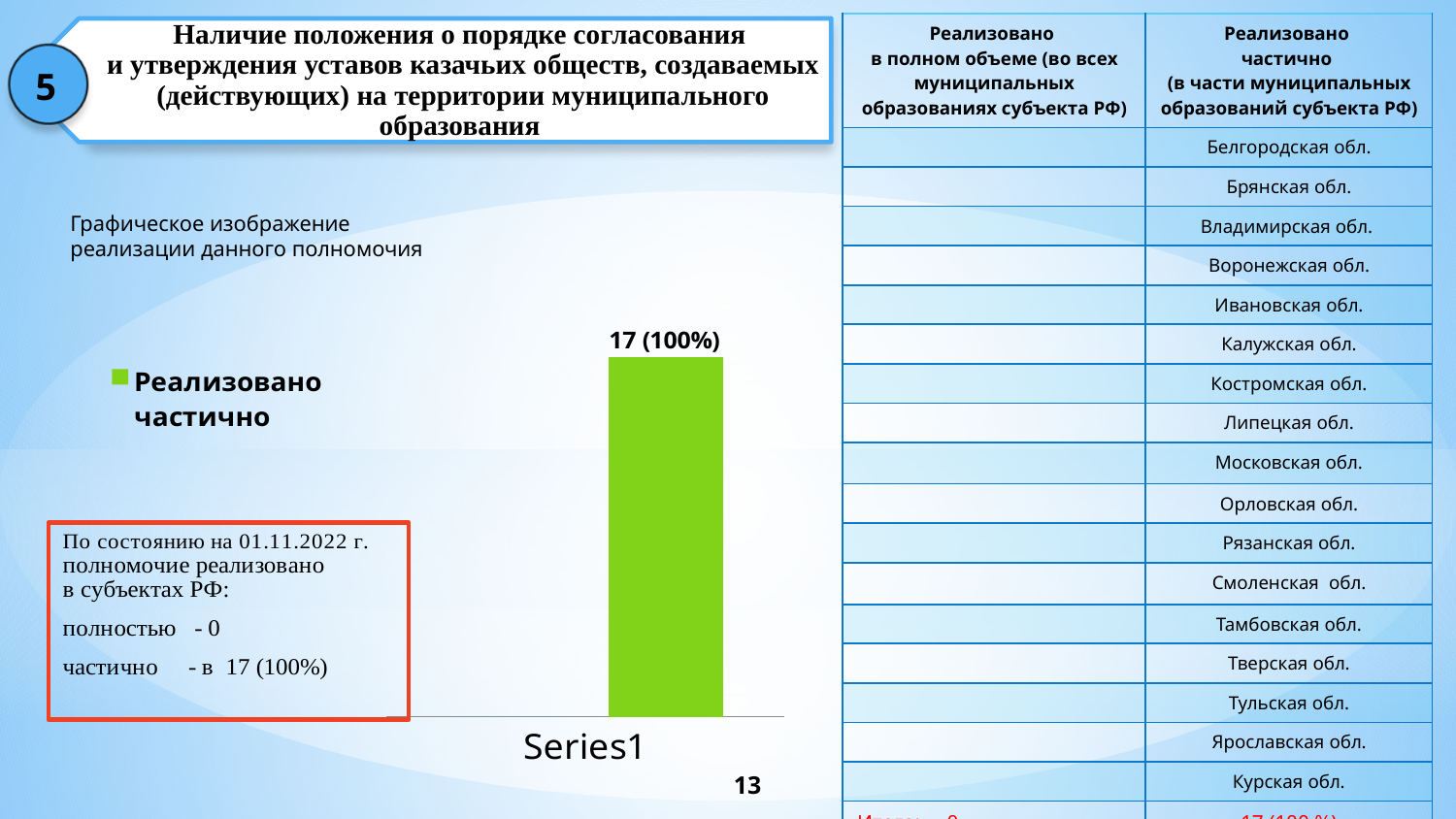
What kind of chart is shown on the slide? bar chart How many bars does the chart contain? 1 How many series does the chart legend list? 1 What value is printed on the bar in the chart? 17 (100%) What is the legend entry of the chart? Реализовано частично What percentage is shown in the data label of the bar for Series1? 100% What colour is the bar in the chart? green What is the category label shown under the bar on the x axis? Series1